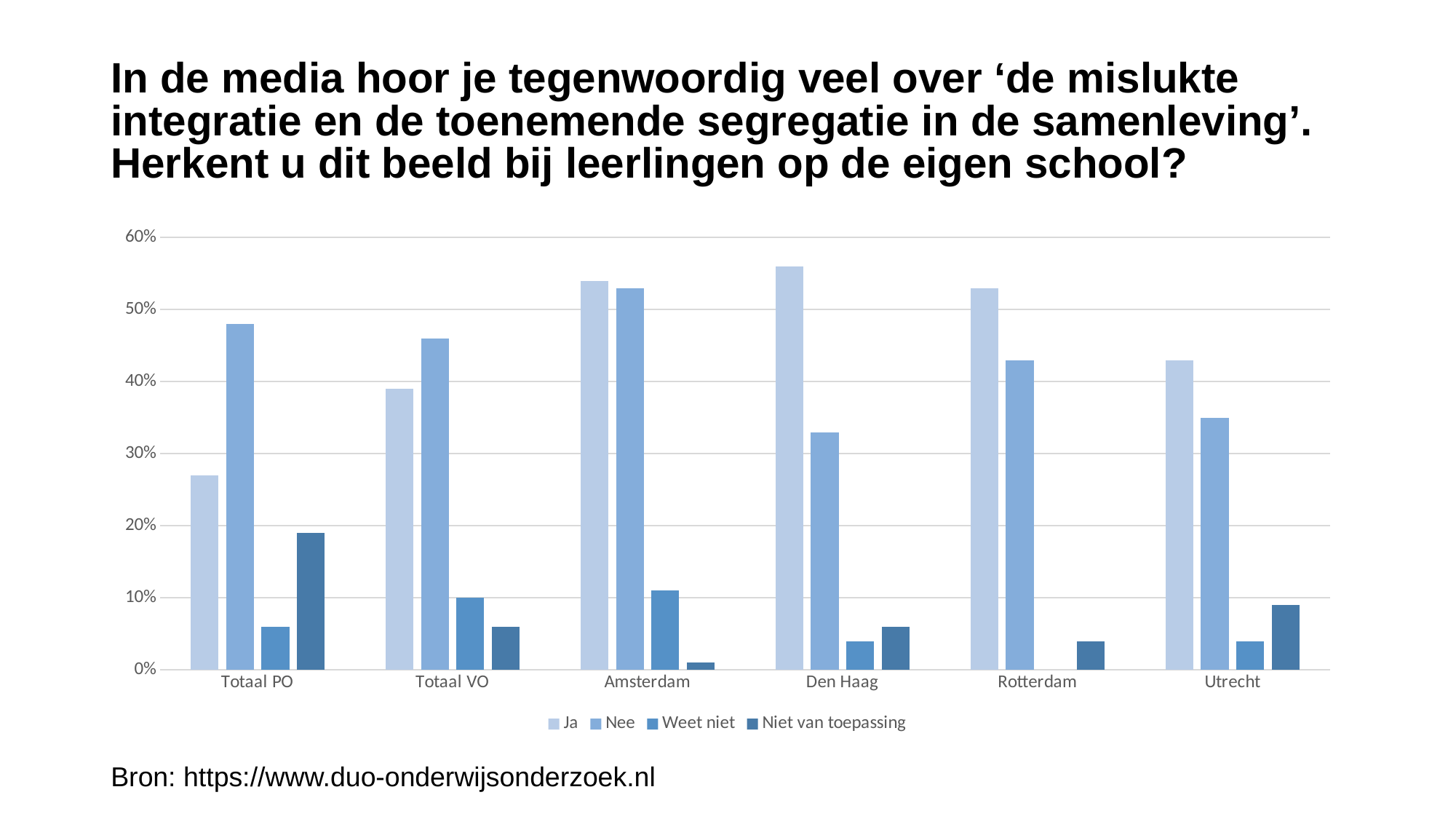
For Den Haag, which is larger: the 'Ja' value or the 'Nee' value? Ja What is the last entry listed in the legend? Niet van toepassing What kind of chart is shown on the slide? bar chart For Totaal PO, which is larger: the 'Ja' value or the 'Nee' value? Nee Which category has the lowest value for the 'Ja' series? Totaal PO Which category has the highest value for the 'Niet van toepassing' series? Totaal PO How many categories are shown along the x axis? 6 How many series does the legend list? 4 Is the 'Ja' value for Totaal PO greater or less than 30%? less Which category has the highest value for the 'Nee' series? Amsterdam Is the 'Nee' value for Utrecht greater or less than 30%? greater Is the 'Ja' value for Den Haag greater or less than 50%? greater